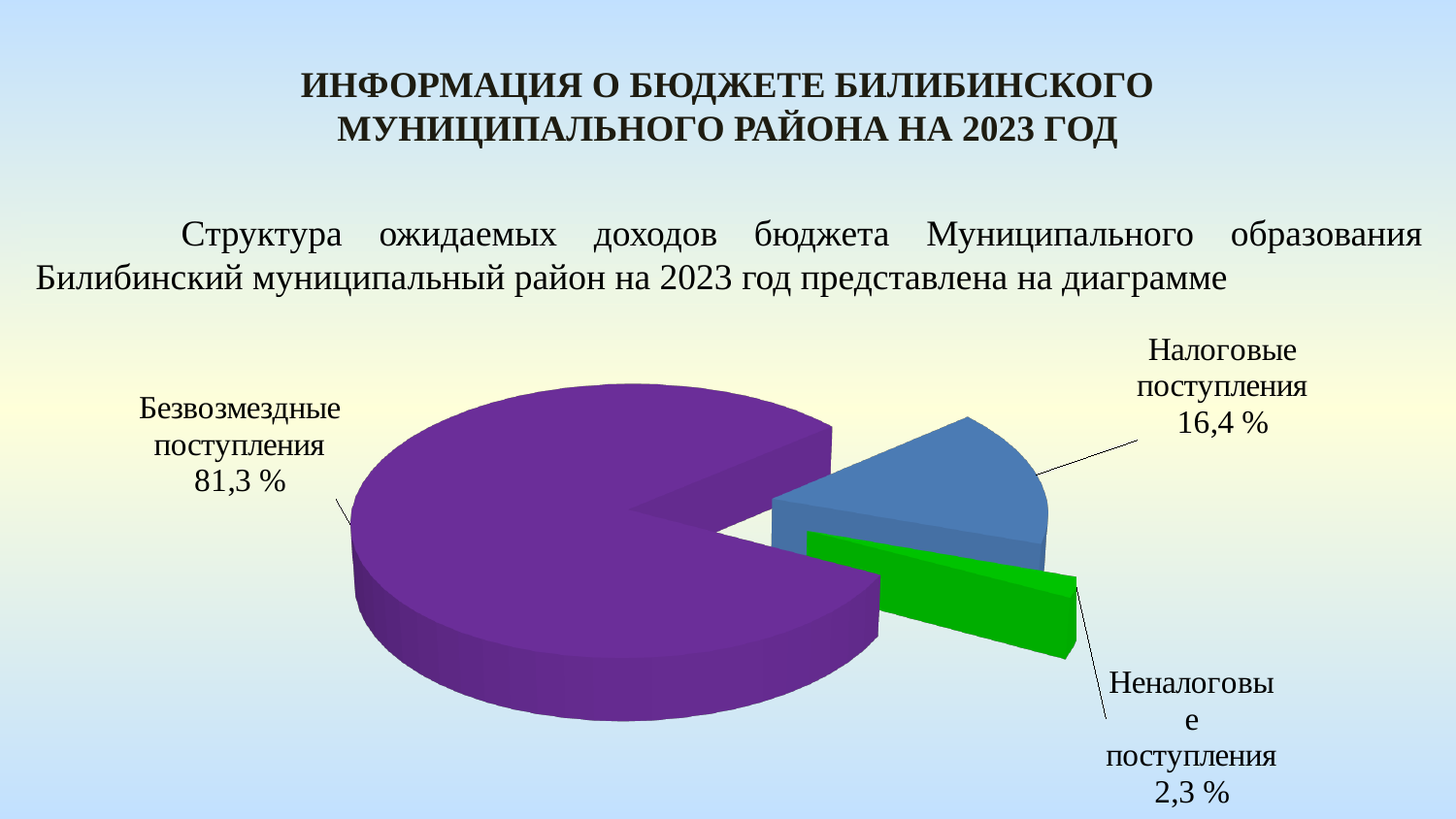
What kind of chart is shown on the slide? pie chart How many slices does the pie chart have? 3 Which slice of the pie is the smallest? Неналоговые поступления What colour is the slice for Неналоговые поступления? green Which slice of the pie is the largest? Безвозмездные поступления What share of the pie is labelled Неналоговые поступления? 2,3 % What colour is the slice for Безвозмездные поступления? purple What is the difference in percentage points between Безвозмездные поступления and Налоговые поступления? 64,9 Which is larger: Налоговые поступления or Неналоговые поступления? Налоговые поступления What share of the pie is labelled Налоговые поступления? 16,4 % What is the difference in percentage points between Налоговые поступления and Неналоговые поступления? 14,1 What share of the pie is labelled Безвозмездные поступления? 81,3 %